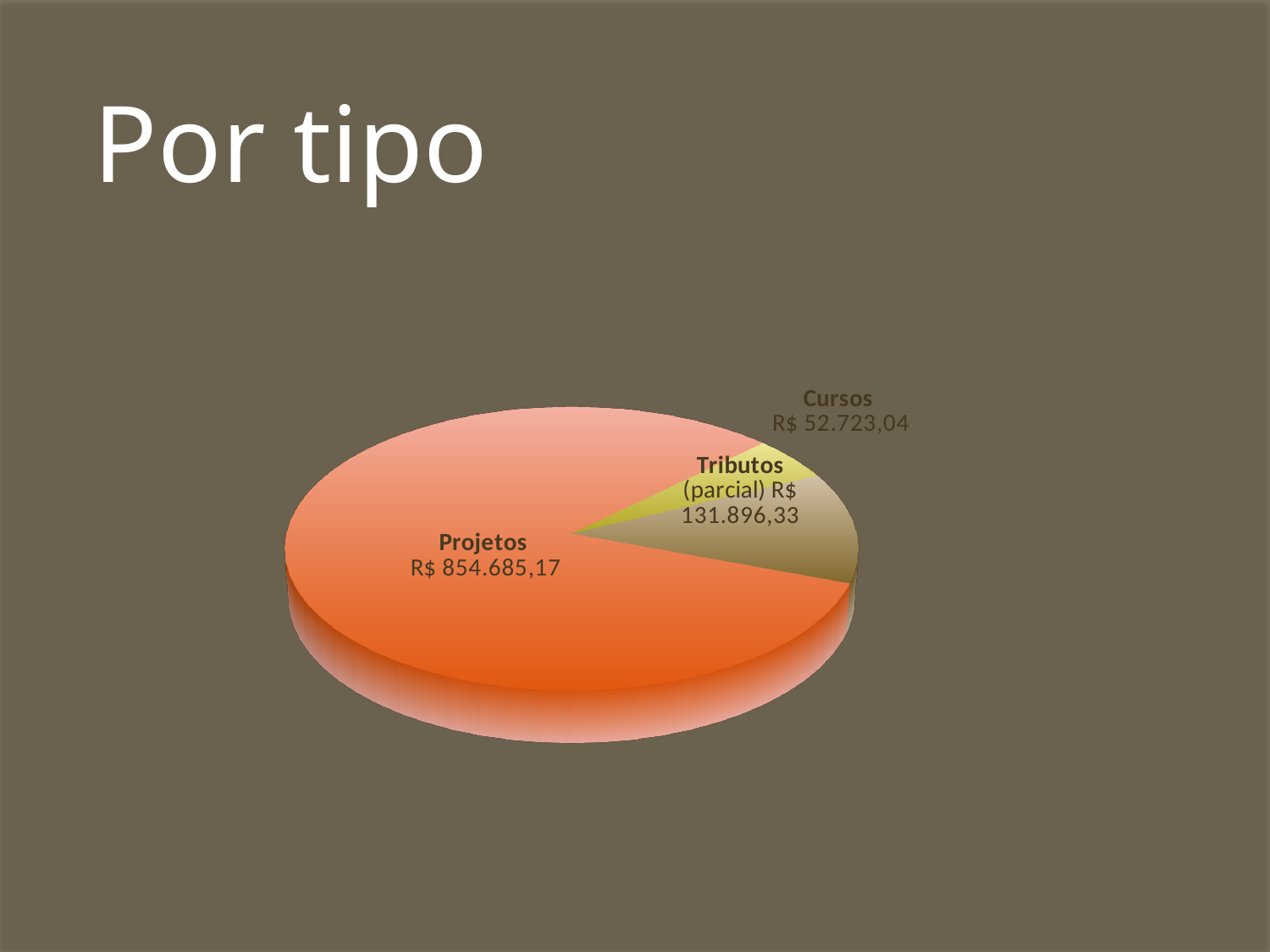
Which category has the smallest slice of the pie? Cursos What is the difference between the values for Projetos and Tributos (parcial)? R$ 722.788,84 What is the value for Cursos? R$ 52.723,04 Which category has the largest slice of the pie? Projetos What is the title of the slide containing the pie chart? Por tipo Which is larger, Tributos (parcial) or Cursos? Tributos (parcial) What kind of chart is shown on the slide? Pie chart What is the difference between the values for Tributos (parcial) and Cursos? R$ 79.173,29 What is the value for Tributos (parcial)? R$ 131.896,33 What is the total of all three slices of the pie? R$ 1.039.304,54 How many slices does the pie chart have? 3 What is the value for Projetos? R$ 854.685,17